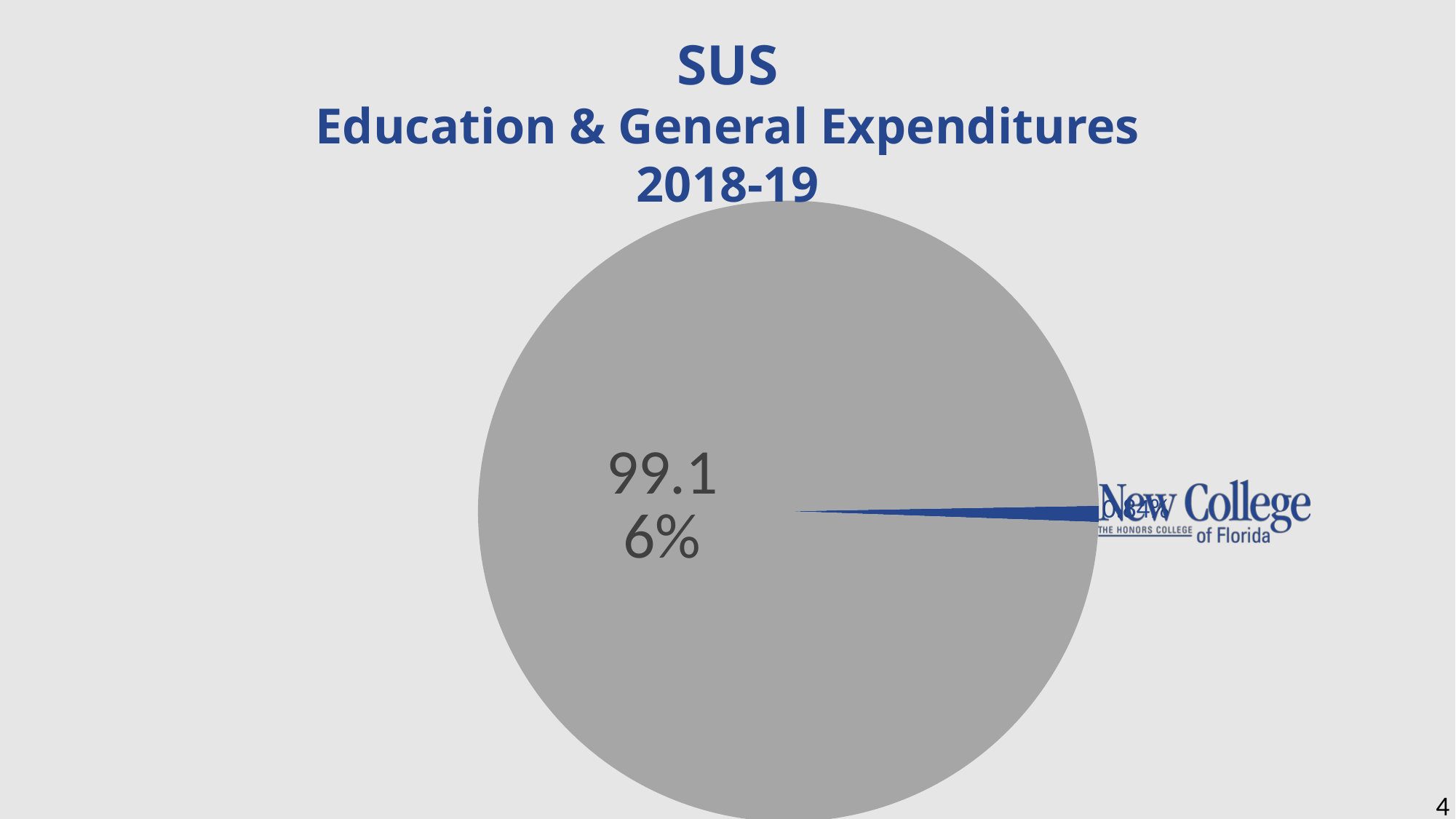
Which fiscal year does the chart cover? 2018-19 How many slices does the pie chart have? 2 Which slice is larger, the gray slice or the blue slice? the gray slice What colour is the largest slice of the pie chart? gray Which slice of the pie chart is the smallest? the blue slice What kind of chart is shown on the slide? pie chart What percentage is printed on the large gray slice of the pie chart? 99.16% What is the title of the chart? SUS Education & General Expenditures 2018-19 What share of the pie does the gray slice represent? 99.16%